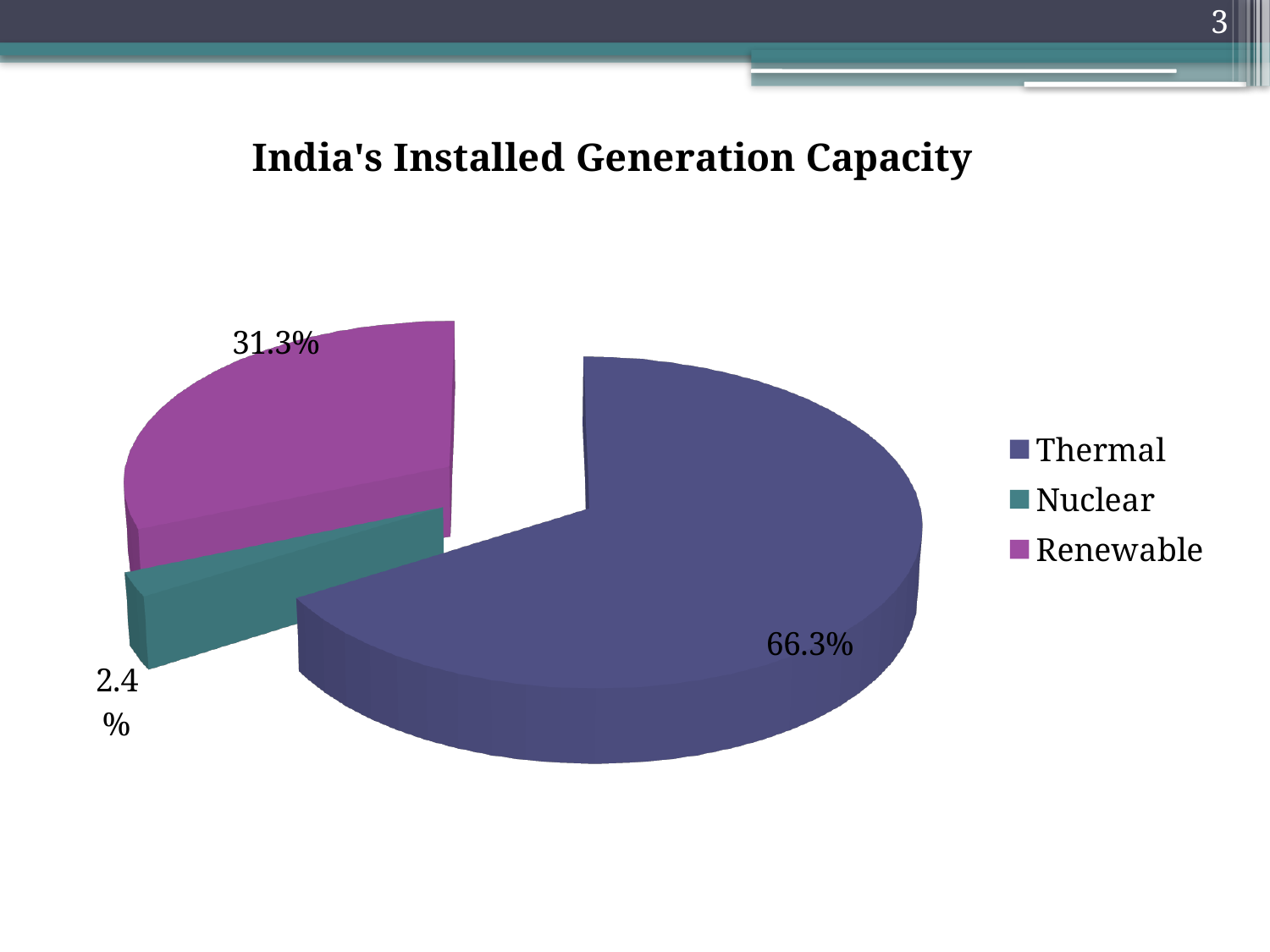
What kind of chart is shown on the slide? Pie chart What is the difference in percentage points between the Renewable and Nuclear shares? 28.9 percentage points What is the difference in percentage points between the Thermal and Renewable shares? 35 percentage points Which category has the largest share of the pie? Thermal What share of India's installed generation capacity is Nuclear? 2.4% What share of India's installed generation capacity is Thermal? 66.3% How many categories are shown in the pie chart? 3 Which colour represents Renewable in the legend? Purple What share of India's installed generation capacity is Renewable? 31.3% Which category has the smallest share of the pie? Nuclear Which is larger, the Renewable share or the Nuclear share? Renewable What is the title of the chart? India's Installed Generation Capacity